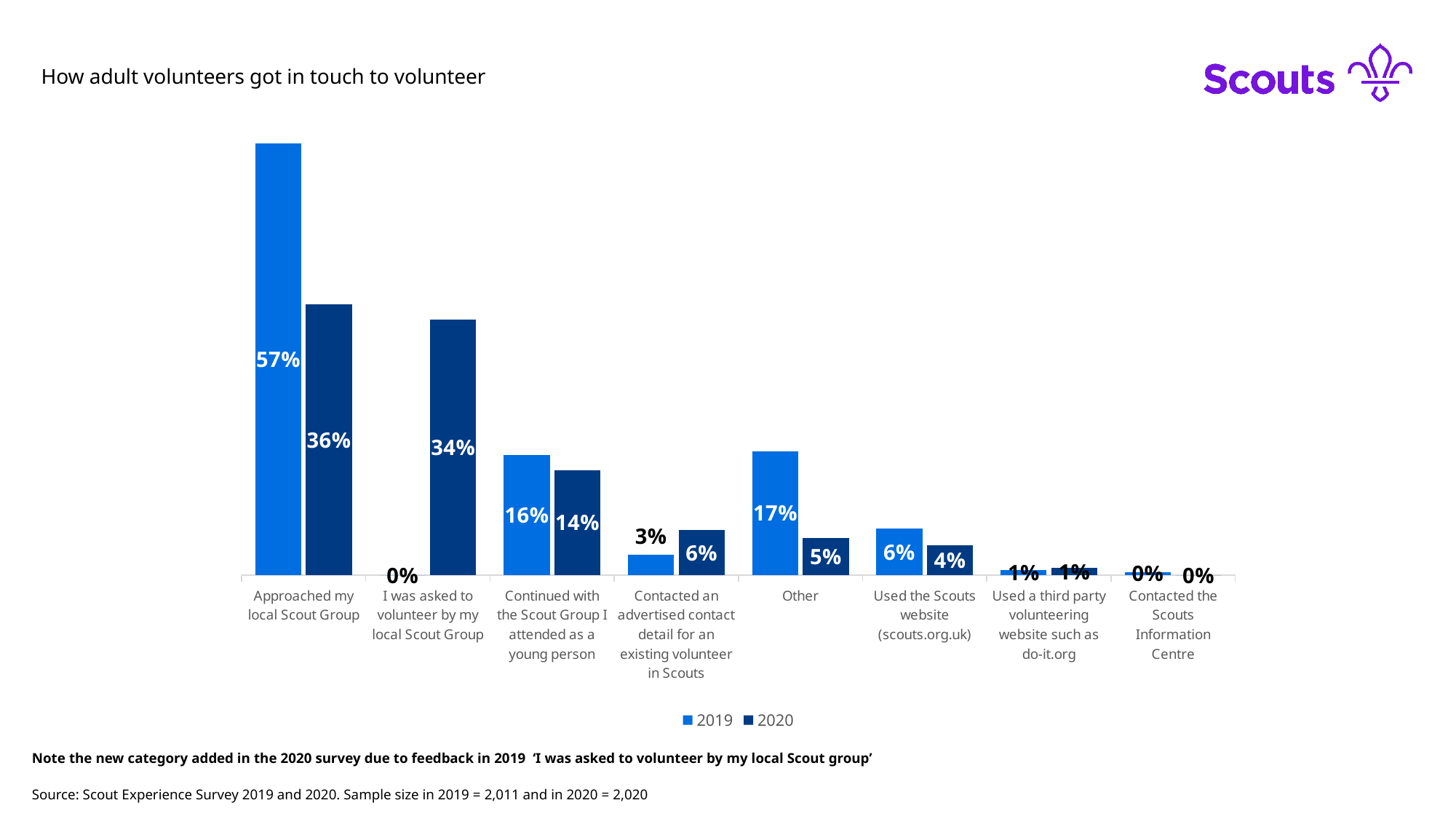
What is the difference between the 2019 and 2020 values for 'Approached my local Scout Group'? 21% How many series does the legend list? 2 What was the 2020 value for 'I was asked to volunteer by my local Scout Group'? 34% What was the 2020 value for 'Continued with the Scout Group I attended as a young person'? 14% For 'Contacted an advertised contact detail for an existing volunteer in Scouts', which year had the larger value, 2019 or 2020? 2020 What was the 2019 value for 'Other'? 17% What kind of chart is shown on the slide? Bar chart Which category had the highest 2020 value? Approached my local Scout Group What was the 2019 value for 'Approached my local Scout Group'? 57% How many categories are shown on the x axis? 8 What is the difference between the 2019 and 2020 values for 'Other'? 12% For 'Used the Scouts website (scouts.org.uk)', which year had the larger value, 2019 or 2020? 2019